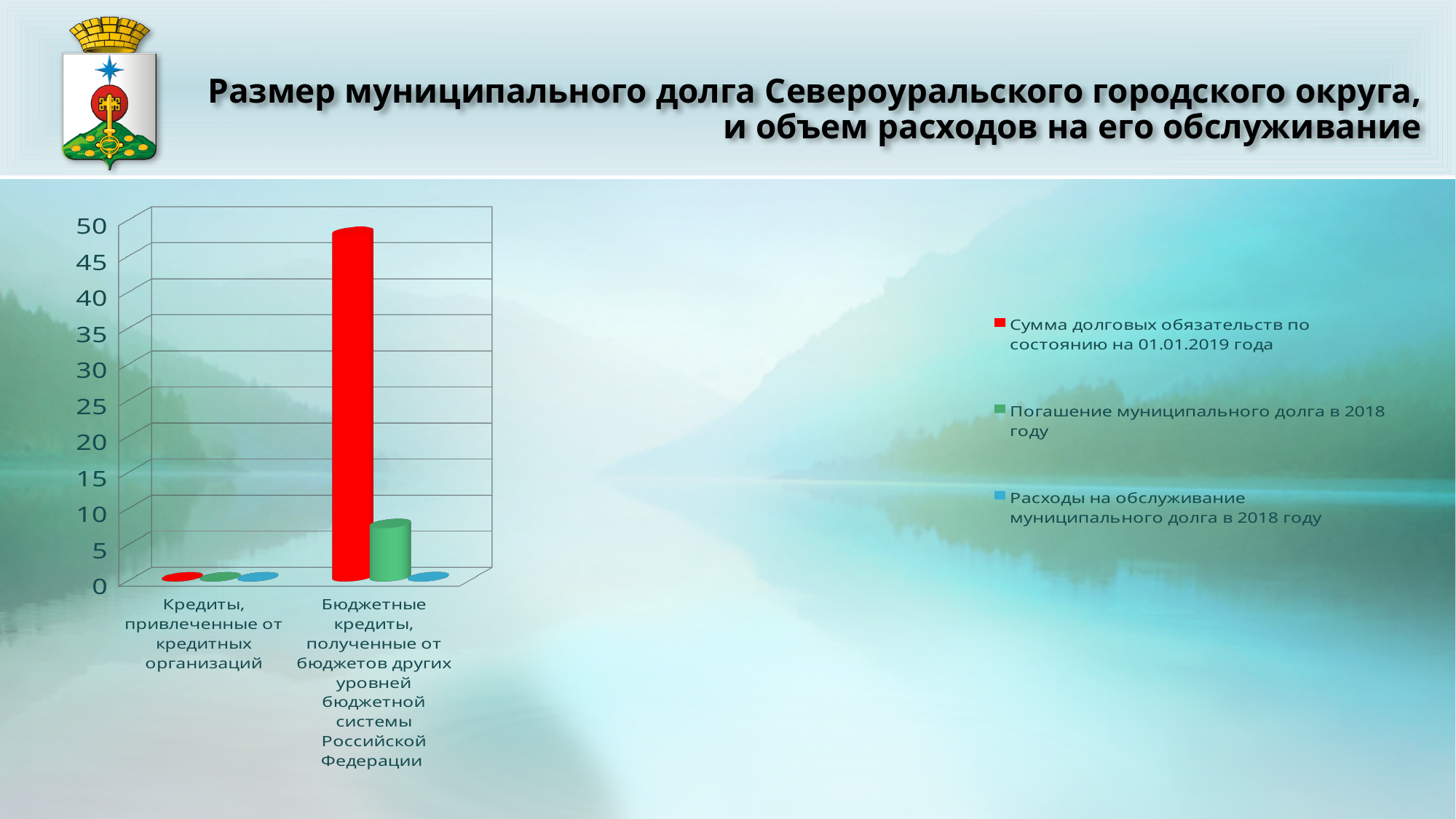
Is the value for "Погашение муниципального долга в 2018 году" in the category "Бюджетные кредиты, полученные от бюджетов других уровней бюджетной системы Российской Федерации" greater or less than 10? less How many categories are shown on the x axis of the chart? 2 Is the value for "Сумма долговых обязательств по состоянию на 01.01.2019 года" in the category "Бюджетные кредиты, полученные от бюджетов других уровней бюджетной системы Российской Федерации" greater or less than 45? greater What kind of chart is shown on the slide? bar chart Is the value for "Погашение муниципального долга в 2018 году" in the category "Бюджетные кредиты, полученные от бюджетов других уровней бюджетной системы Российской Федерации" greater or less than 5? greater Which series has the highest value in the category "Бюджетные кредиты, полученные от бюджетов других уровней бюджетной системы Российской Федерации"? Сумма долговых обязательств по состоянию на 01.01.2019 года Which category has the higher value for "Сумма долговых обязательств по состоянию на 01.01.2019 года"? Бюджетные кредиты, полученные от бюджетов других уровней бюджетной системы Российской Федерации What is the highest value shown on the vertical axis of the chart? 50 What colour represents the series "Расходы на обслуживание муниципального долга в 2018 году" in the chart? blue How many series does the chart legend list? 3 Which is larger in the category "Бюджетные кредиты, полученные от бюджетов других уровней бюджетной системы Российской Федерации": "Погашение муниципального долга в 2018 году" or "Расходы на обслуживание муниципального долга в 2018 году"? Погашение муниципального долга в 2018 году